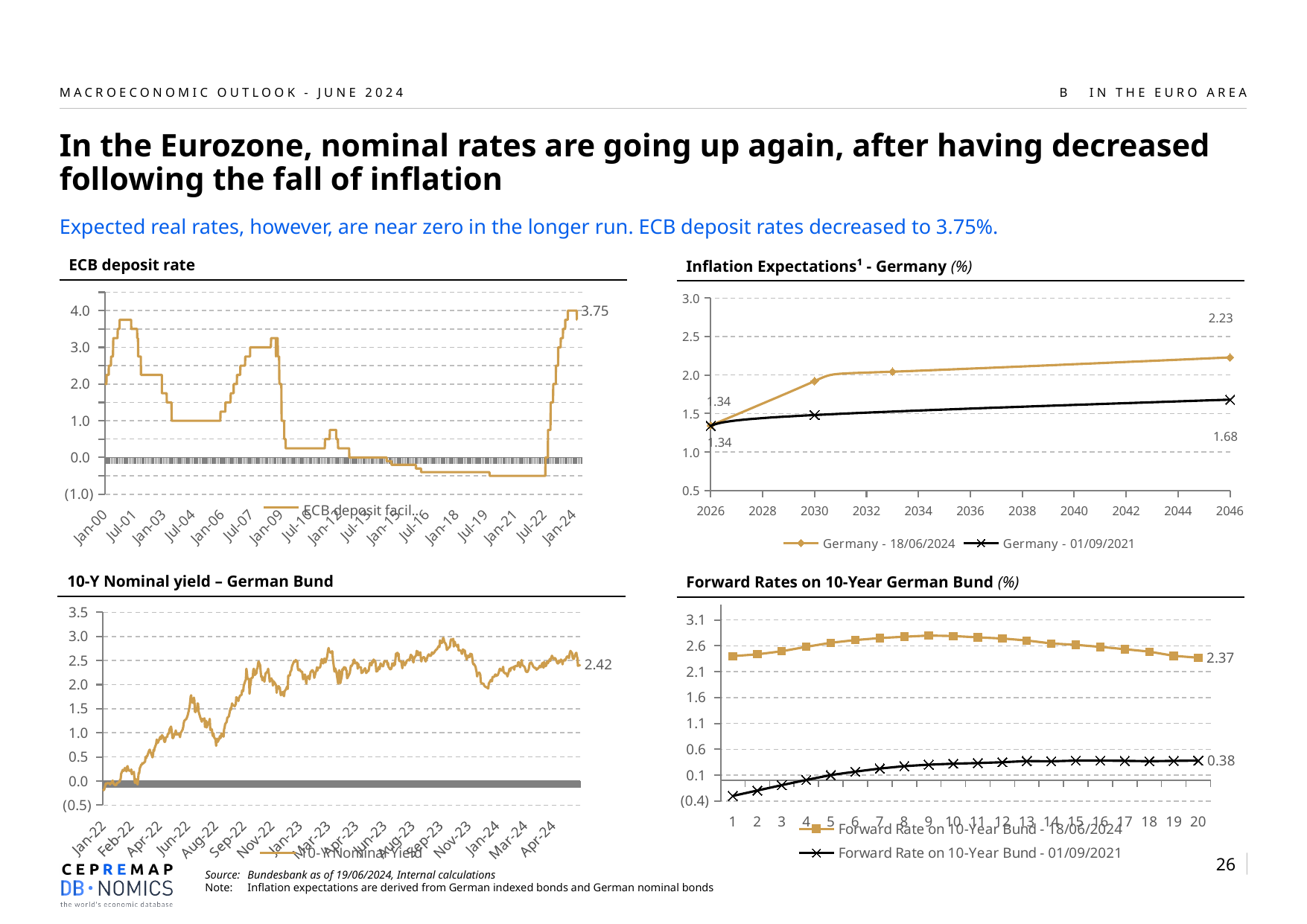
On the Forward Rates on 10-Year German Bund chart, which series has the higher value at year 20, 18/06/2024 or 01/09/2021? 18/06/2024 How many series does the legend of the Forward Rates on 10-Year German Bund chart list? 2 On the 10-Y Nominal yield – German Bund chart, what is the value shown by the data label at the end of the line? 2.42 On the Inflation Expectations - Germany chart, what is the value of both series in 2026? 1.34 On the Inflation Expectations - Germany chart, what is the value for the Germany - 18/06/2024 series in 2046? 2.23 On the Forward Rates on 10-Year German Bund chart, what is the value of the 01/09/2021 series at year 20? 0.38 On the ECB deposit rate chart, what is the latest value shown by the data label at the end of the line? 3.75 On the Inflation Expectations - Germany chart, does the Germany - 18/06/2024 series rise or fall from 2026 to 2046? rise On the Forward Rates on 10-Year German Bund chart, what is the value of the 18/06/2024 series at year 20? 2.37 On the Forward Rates on 10-Year German Bund chart, is the value of the 01/09/2021 series at year 1 greater or less than 0.1? less On the Inflation Expectations - Germany chart, what is the value for the Germany - 01/09/2021 series in 2046? 1.68 On the Inflation Expectations - Germany chart, what is the difference between the two series' values in 2046? 0.55